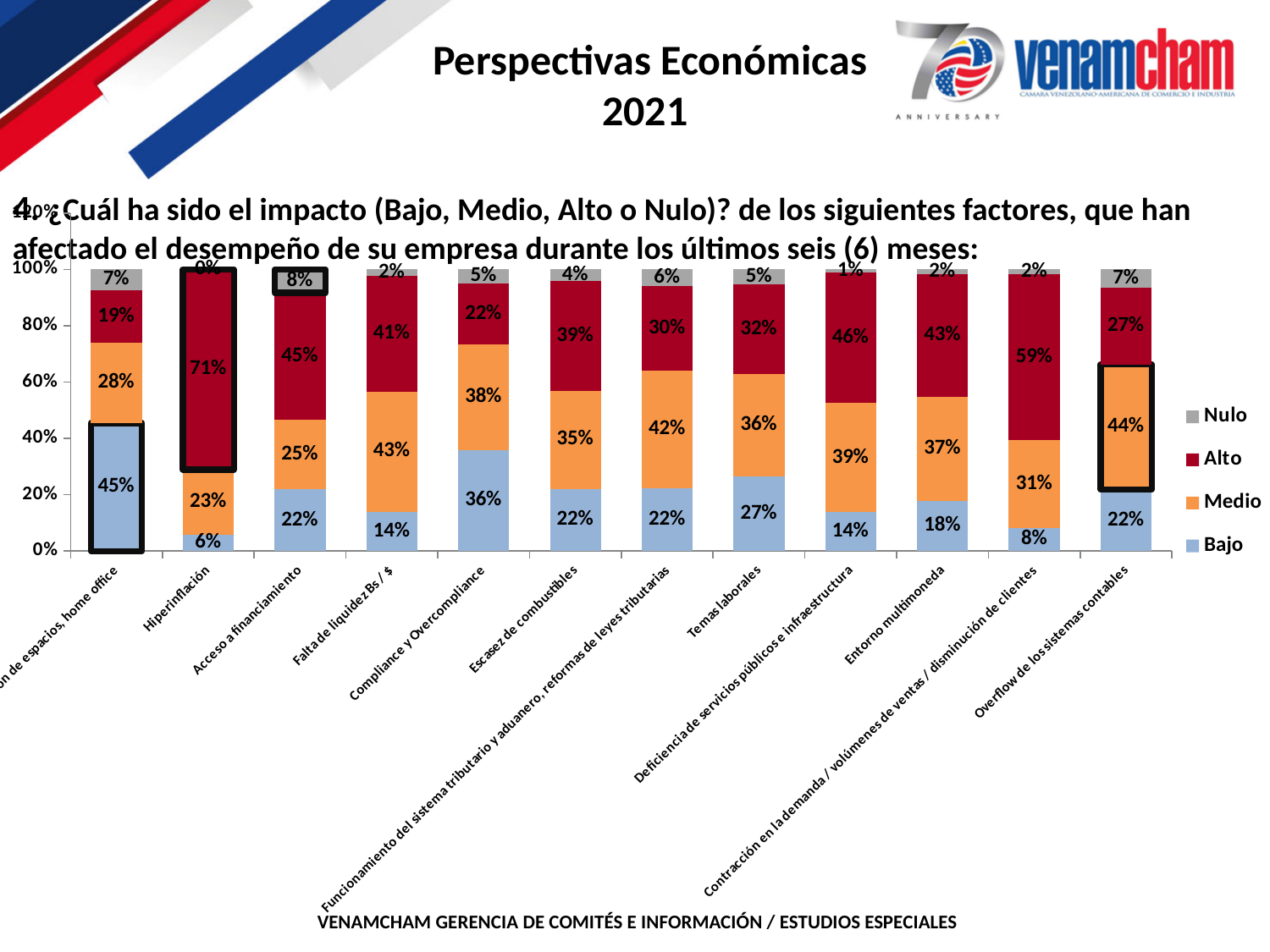
Which is larger for Falta de liquidez Bs / $: the Medio value or the Alto value? Medio What is the Nulo value for Acceso a financiamiento? 8% Which category has the lowest Bajo value? Hiperinflación Which is larger: the Bajo value for Temas laborales or the Bajo value for Deficiencia de servicios públicos e infraestructura? Temas laborales What is the Medio value for Overflow de los sistemas contables? 44% What is the Alto value for Hiperinflación? 71% Which category has the highest Alto value? Hiperinflación What kind of chart is shown on the slide? stacked bar chart What is the Bajo value for Compliance y Overcompliance? 36% What is the difference between the Alto values for Contracción en la demanda / volúmenes de ventas / disminución de clientes and Entorno multimoneda? 16% How many series does the legend list? 4 Which legend entry is shown in grey? Nulo